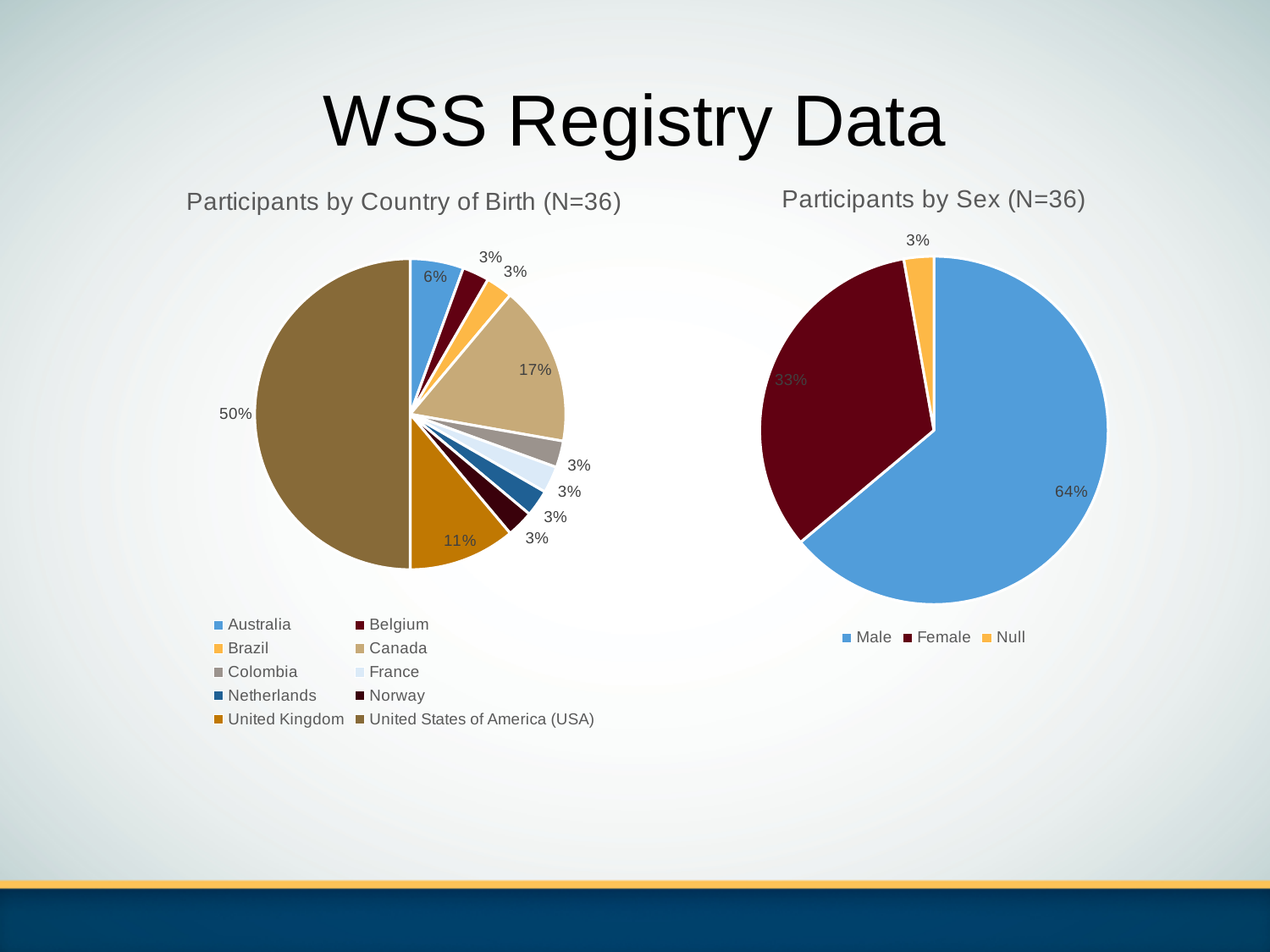
What kind of chart is the 'Participants by Sex (N=36)' chart? Pie chart In the 'Participants by Country of Birth (N=36)' chart, what share of participants were born in Australia? 6% In the 'Participants by Sex (N=36)' chart, what share of participants are Female? 33% In the 'Participants by Sex (N=36)' chart, which category has the smallest slice? Null In the 'Participants by Country of Birth (N=36)' chart, what share of participants were born in the United Kingdom? 11% In the 'Participants by Sex (N=36)' chart, which is larger, the Male share or the Female share? Male In the 'Participants by Country of Birth (N=36)' chart, what share of participants were born in the United States of America (USA)? 50% In the 'Participants by Sex (N=36)' chart, what share of participants are Male? 64% In the 'Participants by Country of Birth (N=36)' chart, what is the difference between the shares for the United States of America (USA) and Canada? 33% In the 'Participants by Country of Birth (N=36)' chart, what share of participants were born in Canada? 17% In the 'Participants by Country of Birth (N=36)' chart, how many countries are listed in the legend? 10 In the 'Participants by Country of Birth (N=36)' chart, which country has the largest slice? United States of America (USA)